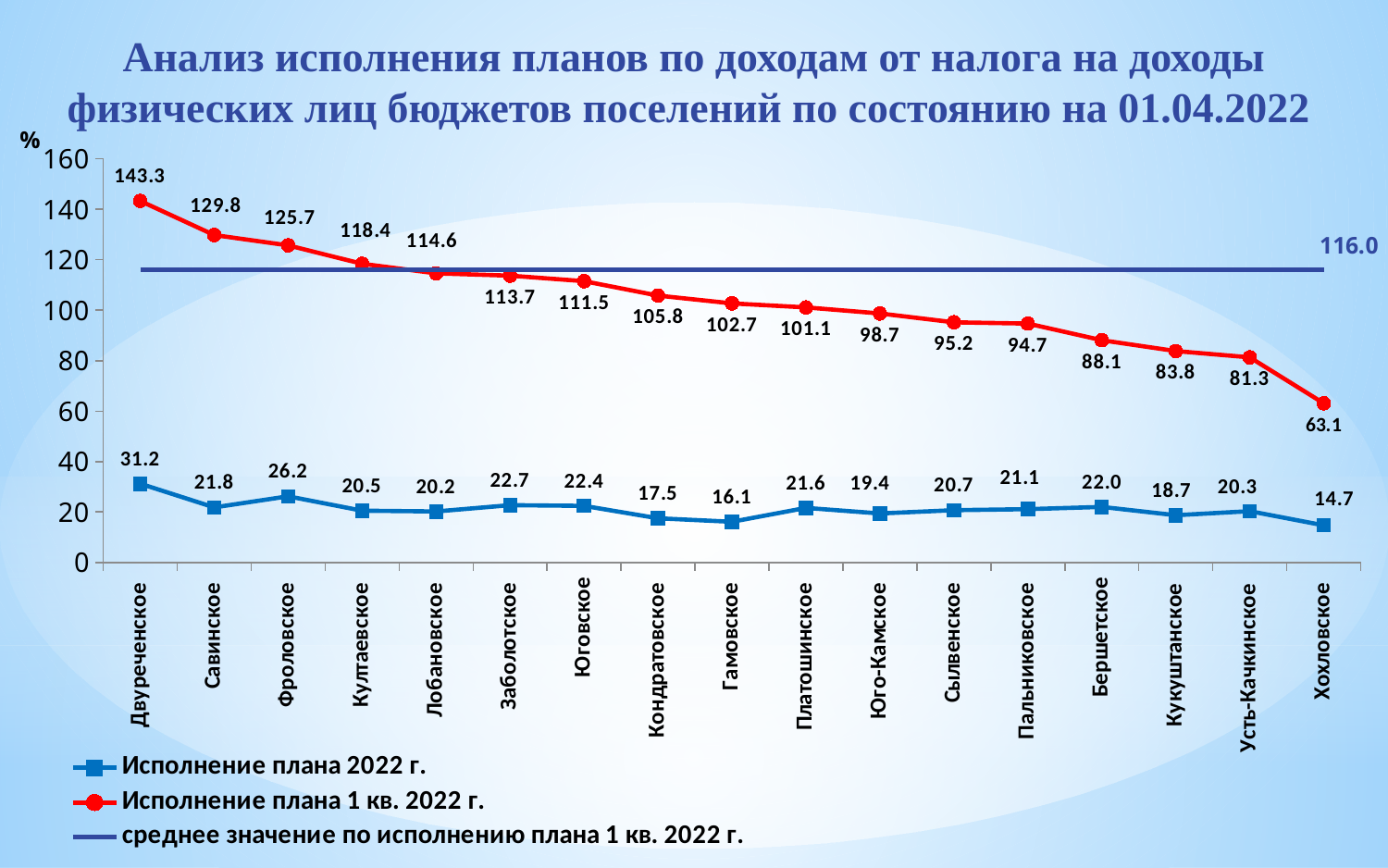
What is the value of 'Исполнение плана 1 кв. 2022 г.' for Двуреченское? 143.3 What is the value of 'Исполнение плана 2022 г.' for Гамовское? 16.1 Does the 'Исполнение плана 1 кв. 2022 г.' series rise or fall from left to right along the x axis? Fall How many entries does the legend list? 3 Which settlement has the highest value for 'Исполнение плана 2022 г.'? Двуреченское What is the difference between the 'Исполнение плана 1 кв. 2022 г.' values for Двуреченское and Хохловское? 80.2 What kind of chart is shown on the slide? Line chart What is the value of the average line 'среднее значение по исполнению плана 1 кв. 2022 г.'? 116.0 What colour is the line for 'Исполнение плана 1 кв. 2022 г.'? Red How many settlements are shown on the x axis? 17 Which is larger for 'Исполнение плана 2022 г.': Фроловское or Савинское? Фроловское Which settlement has the lowest value for 'Исполнение плана 1 кв. 2022 г.'? Хохловское